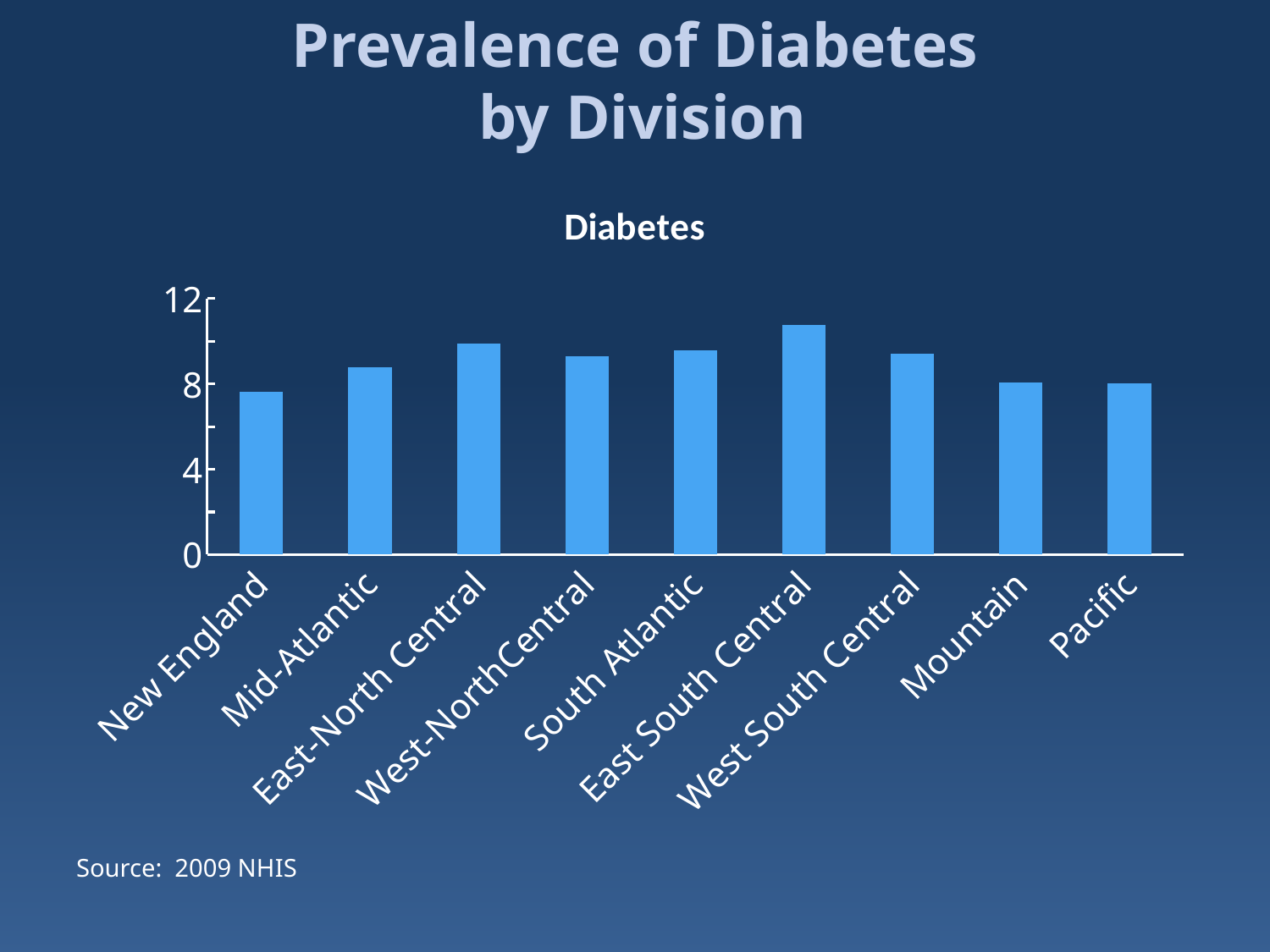
What source is cited for the chart data? 2009 NHIS What is the title shown directly above the chart area? Diabetes Which division has the lowest prevalence of diabetes? New England Is the value for East-North Central greater or less than 8? greater Which is larger, the value for East-North Central or the value for Mid-Atlantic? East-North Central Which is larger, the value for South Atlantic or the value for Mountain? South Atlantic Which division has the highest prevalence of diabetes? East South Central Is the value for East South Central greater or less than 12? less Is the value for New England greater or less than 8? less What kind of chart is shown on the slide? bar chart How many divisions are plotted on the chart? 9